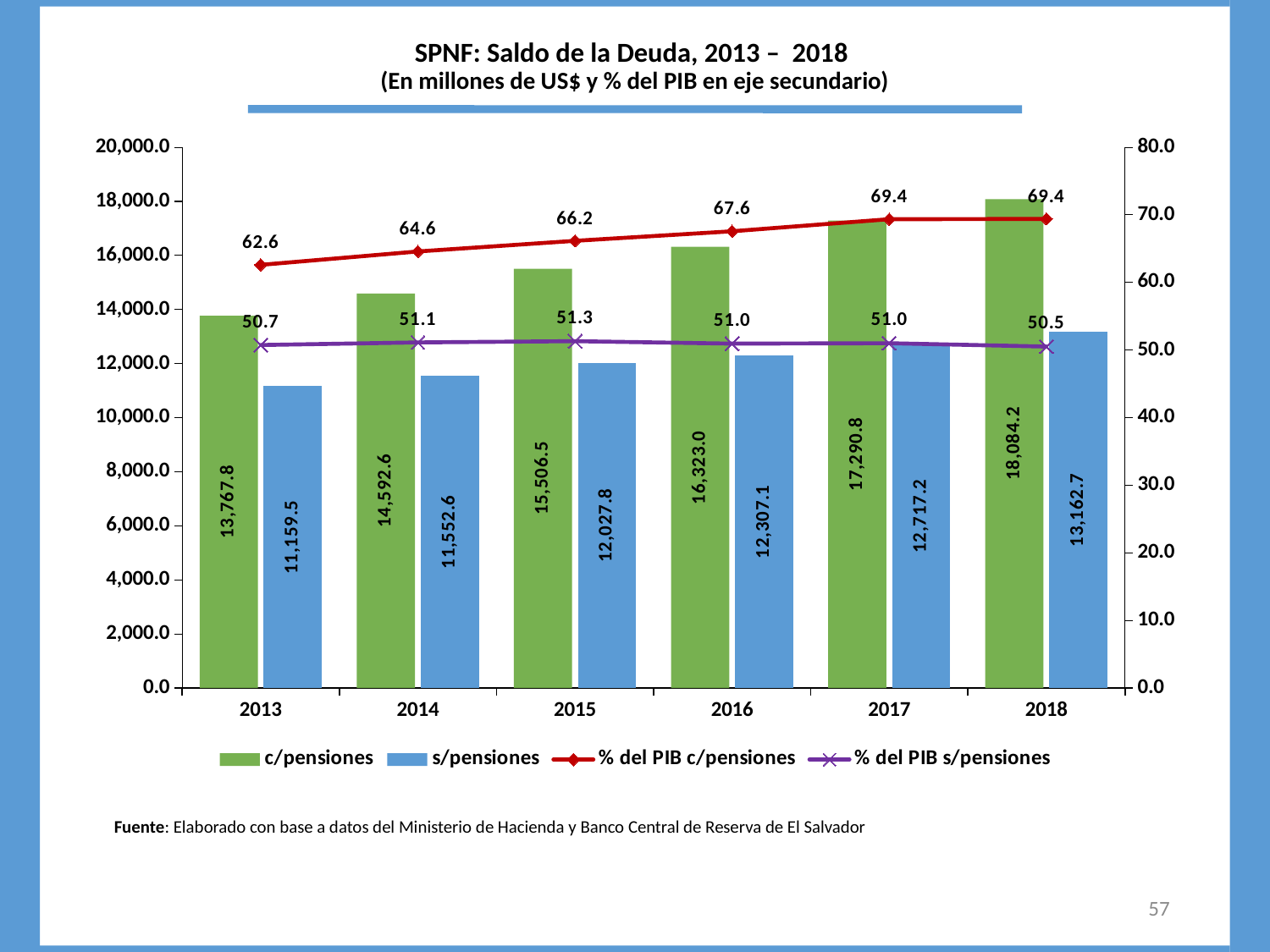
What is the % del PIB s/pensiones value for 2016? 51.0 What is the value of s/pensiones for 2018? 13,162.7 Which year has the lowest s/pensiones value? 2013 What is the difference between the c/pensiones and s/pensiones values for 2017? 4,573.6 How many series does the legend list? 4 What kind of chart is this? Combined bar and line chart What is the value of c/pensiones for 2015? 15,506.5 Which year has the highest c/pensiones value? 2018 What is the % del PIB c/pensiones value for 2013? 62.6 Which is larger, the c/pensiones value for 2014 or the s/pensiones value for 2018? c/pensiones for 2014 How many years are shown on the x axis? 6 Does the % del PIB c/pensiones line rise or fall from 2013 to 2018? Rise